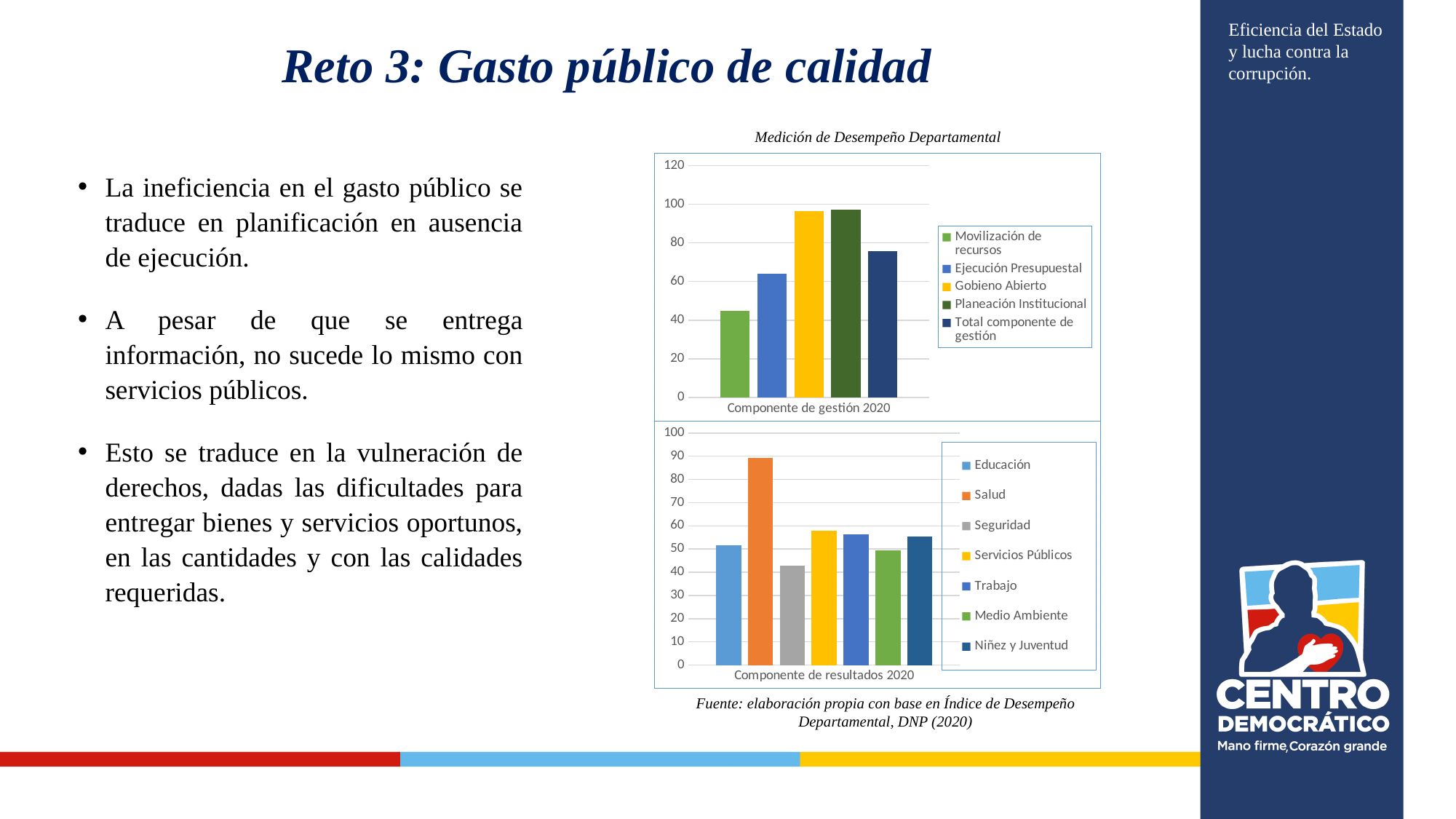
What kind of chart is the bottom chart (Componente de resultados 2020)? bar chart In the bottom chart (Componente de resultados 2020), which series has the highest value? Salud In the top chart (Componente de gestión 2020), is the value for Ejecución Presupuestal greater or less than 80? less In the top chart (Componente de gestión 2020), is the value for Total componente de gestión greater or less than 60? greater In the bottom chart (Componente de resultados 2020), which is larger: Educación or Seguridad? Educación In the bottom chart (Componente de resultados 2020), is the value for Salud greater or less than 80? greater How many series does the legend of the top chart (Componente de gestión 2020) list? 5 In the bottom chart (Componente de resultados 2020), which series has the lowest value? Seguridad How many series does the legend of the bottom chart (Componente de resultados 2020) list? 7 In the top chart (Componente de gestión 2020), which series has the lowest value? Movilización de recursos In the top chart (Componente de gestión 2020), which is larger: Gobierno Abierto or Ejecución Presupuestal? Gobierno Abierto